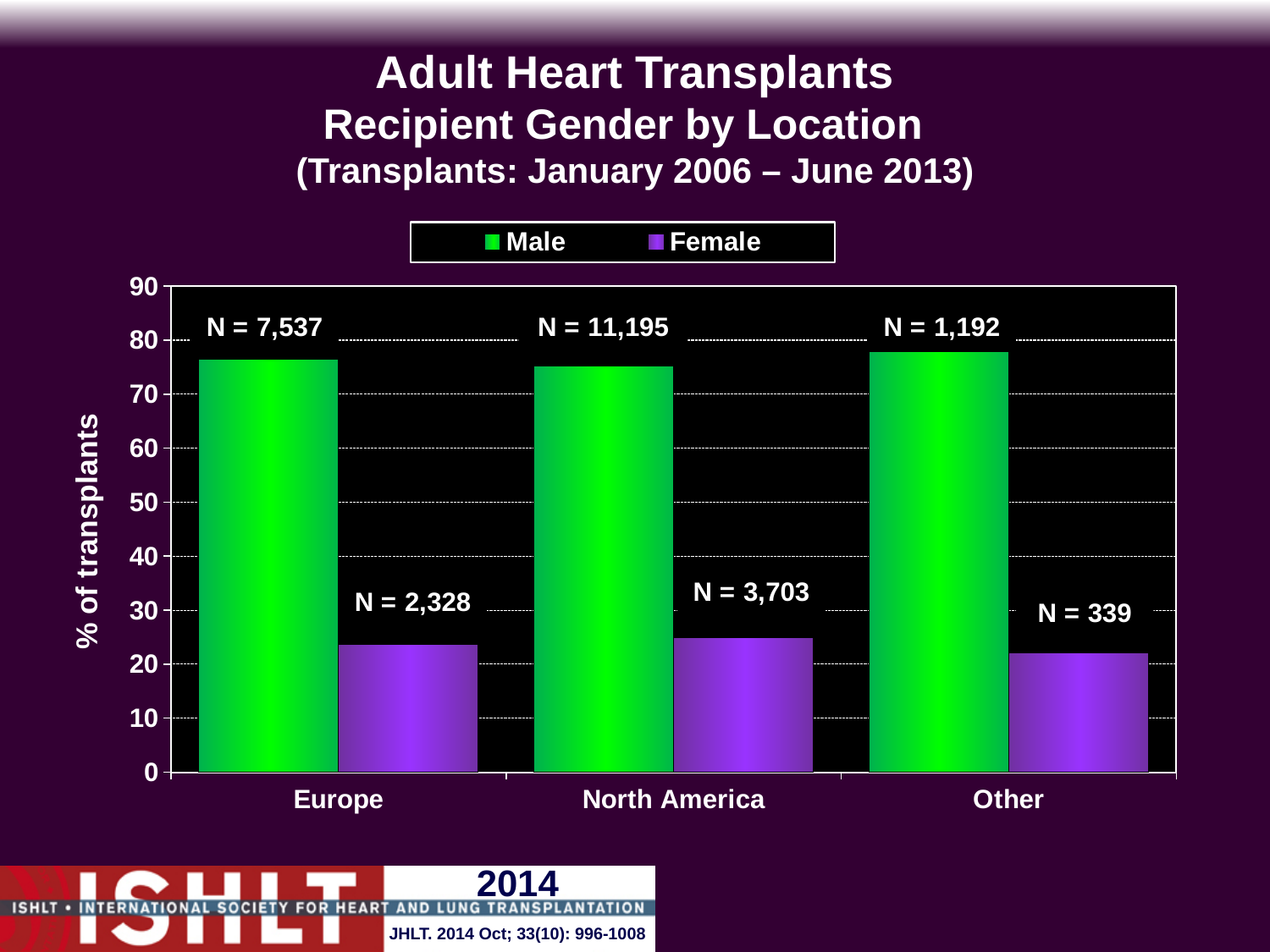
What is the N value printed above the Male bar for Europe? N = 7,537 How many series does the legend list? 2 How many location categories are shown on the x axis? 3 What is the N value printed above the Female bar for Other? N = 339 What is the N value printed above the Female bar for North America? N = 3,703 What kind of chart is shown on the slide? bar chart Is the Male value for North America greater or less than 70? greater What is the N value printed above the Male bar for Other? N = 1,192 What is the label on the y axis? % of transplants For North America, which is larger, the Male or the Female percentage? Male Is the Male value for Other greater or less than 80? less Is the Female value for Europe greater or less than 30? less